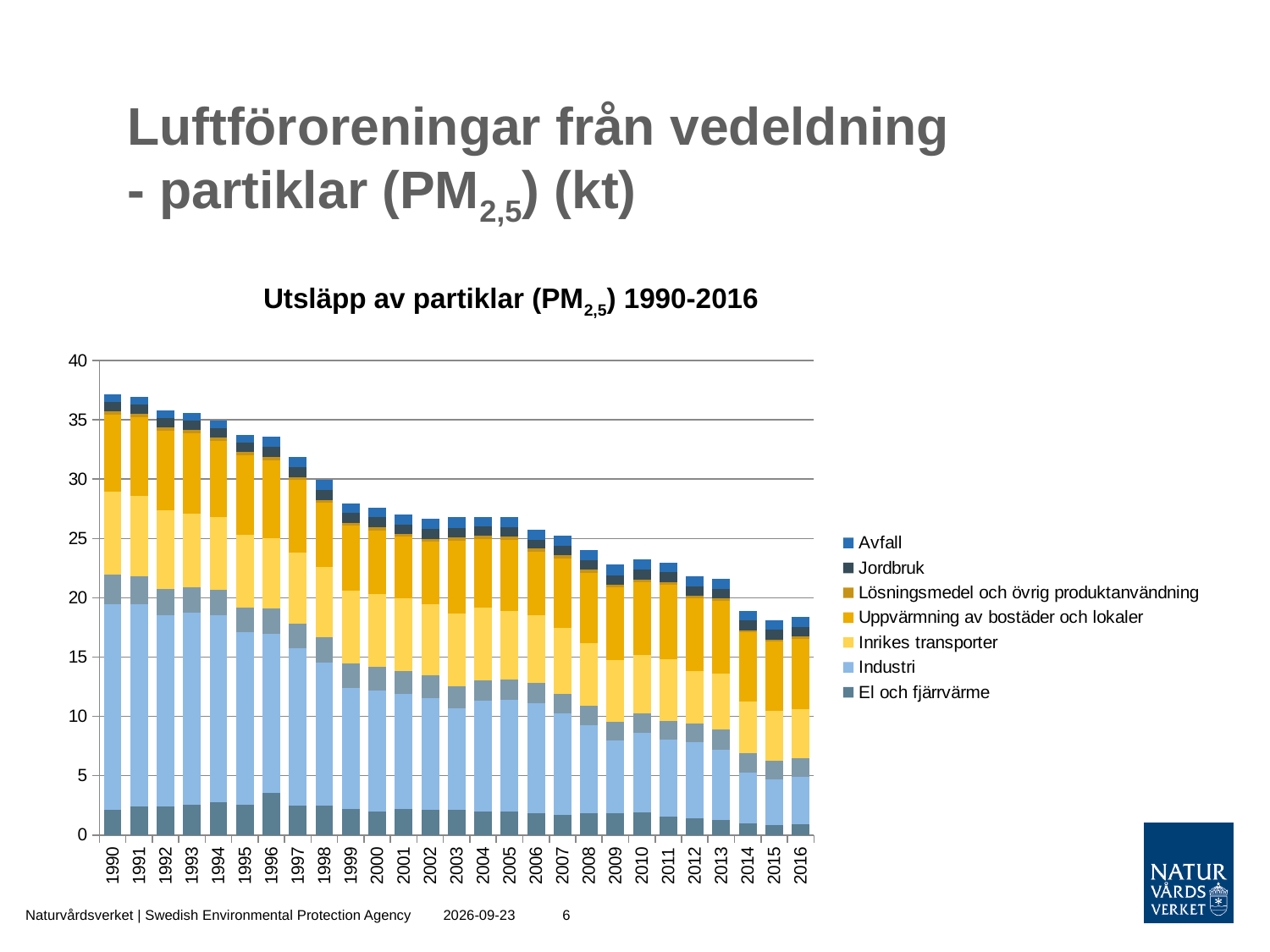
Which year has the highest total emissions? 1990 Do the total emissions rise or fall from 1990 to 2016? Fall Is the total value for 2000 greater or less than 25? greater Is the total value for 2010 greater or less than 25? less How many series does the chart's legend list? 7 How many years are shown along the x axis of the chart? 27 Which year has the larger total emissions, 1995 or 2005? 1995 What kind of chart is shown on the slide? Stacked bar chart Which series is listed first in the chart's legend? Avfall What is the title of the chart? Utsläpp av partiklar (PM2,5) 1990-2016 Is the total value for 2016 greater or less than 20? less